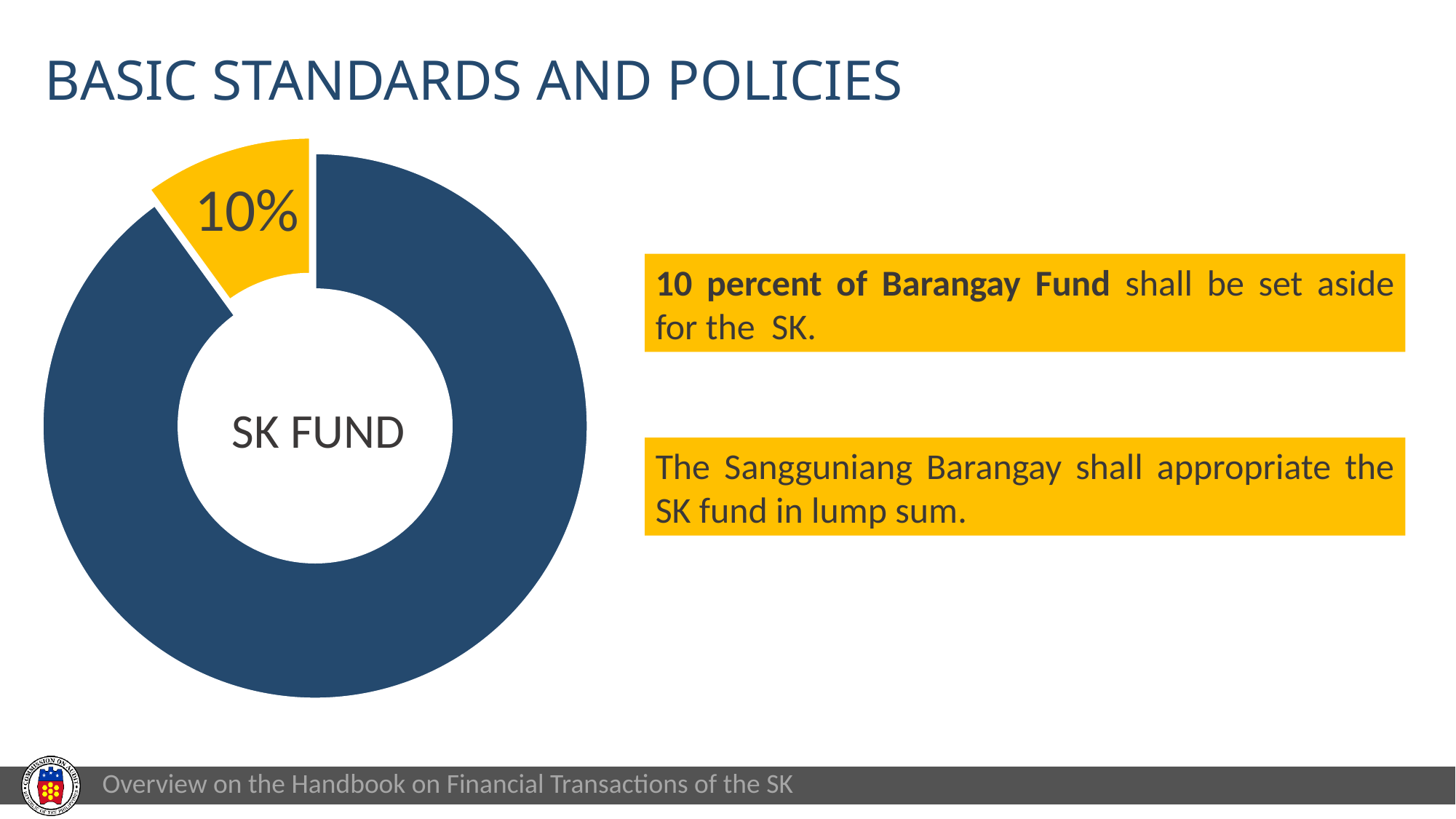
Which slice of the doughnut chart is larger, the yellow one or the dark blue one? the dark blue one Is the share of the yellow slice greater or less than 50%? less What percentage is printed on the yellow slice of the doughnut chart? 10% What text is written in the centre of the doughnut chart? SK FUND How many slices does the doughnut chart have? 2 Which slice of the doughnut chart is the smallest? the yellow slice (10%) What kind of chart is shown on the slide? doughnut chart What share of the doughnut chart does the yellow slice represent? 10% What colour is the slice labelled 10%? yellow